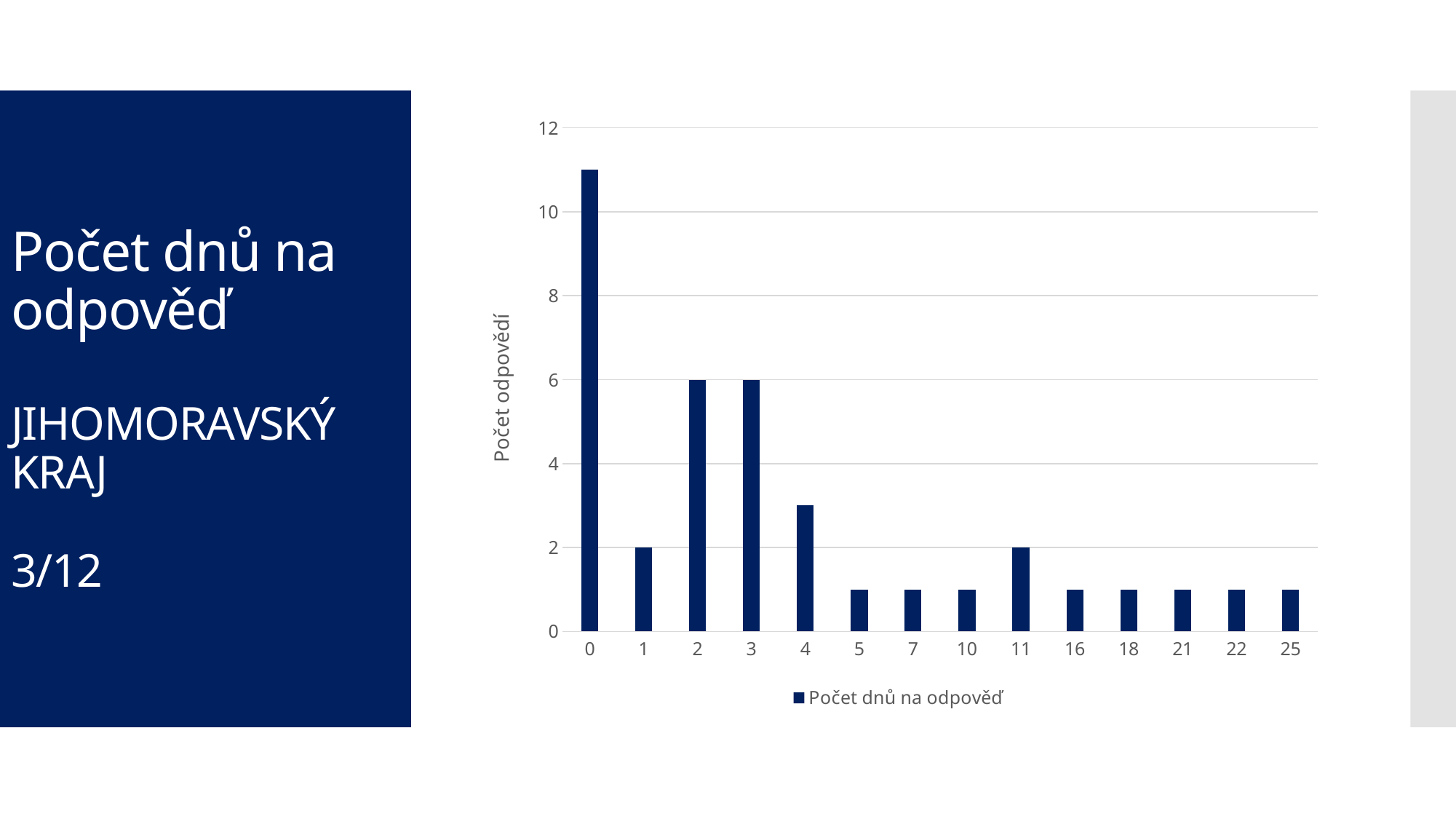
What is the label of the vertical axis? Počet odpovědí What is the value for category 2? 6 Is the value for category 0 greater or less than 10? greater Which category has the highest value in the chart? 0 Which is larger, the value for category 4 or the value for category 11? 4 What type of chart is shown on the slide? bar chart What is the value for category 1? 2 How many series does the legend list? 1 What is the difference between the values for category 2 and category 1? 4 How many categories are shown on the x axis of the chart? 14 What is the legend entry for the series in the chart? Počet dnů na odpověď What is the value for category 11? 2